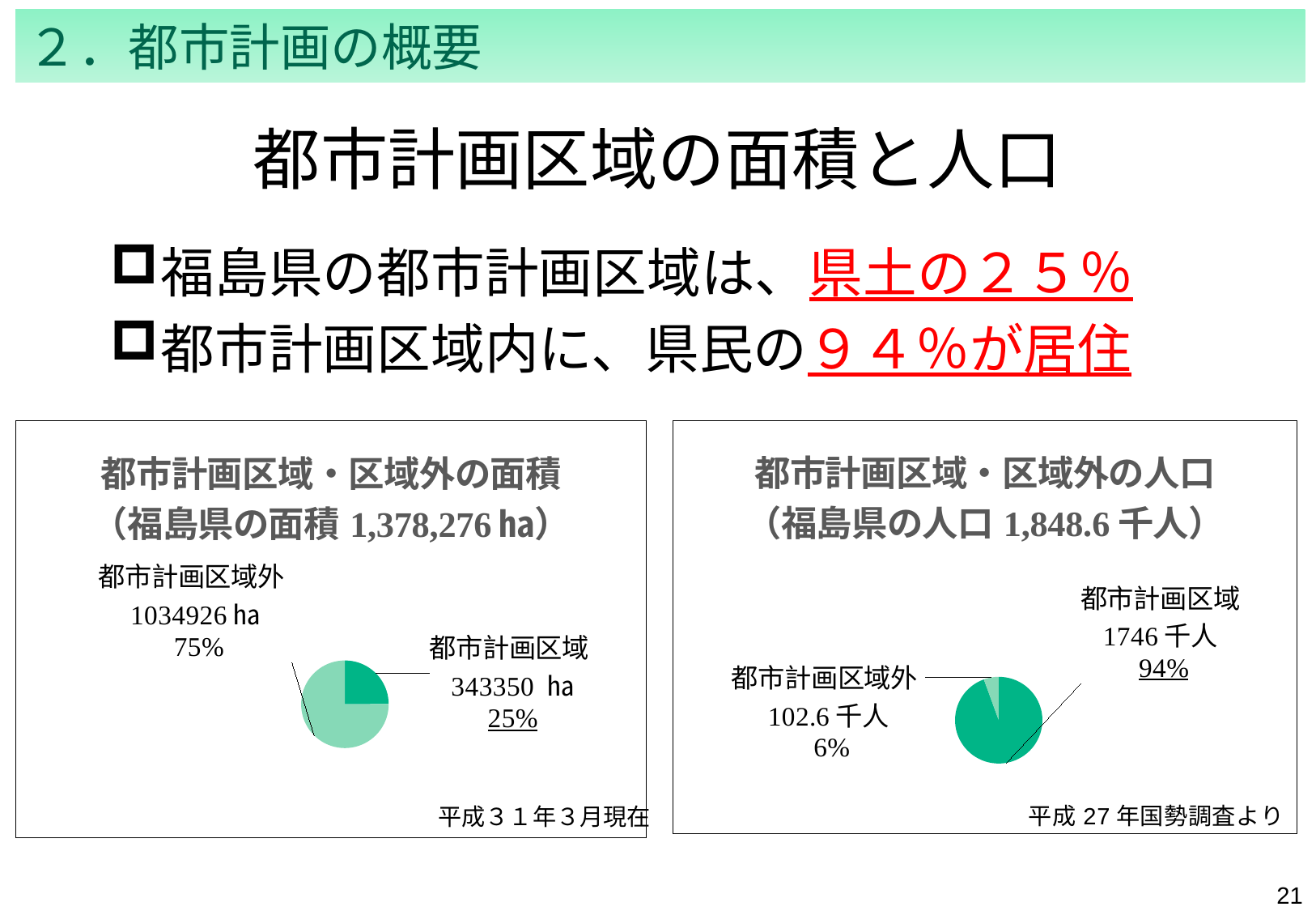
In the left chart (都市計画区域・区域外の面積), what is the area of 都市計画区域? 343350 ha How many slices does the right chart (都市計画区域・区域外の人口) have? 2 In the right chart (都市計画区域・区域外の人口), which slice is the smallest? 都市計画区域外 In the right chart (都市計画区域・区域外の人口), what share of the pie does 都市計画区域外 take? 6% In the right chart (都市計画区域・区域外の人口), what is the population of 都市計画区域? 1746 千人 In the left chart (都市計画区域・区域外の面積), which slice is the largest? 都市計画区域外 In the left chart (都市計画区域・区域外の面積), what is the area of 都市計画区域外? 1034926 ha In the right chart (都市計画区域・区域外の人口), which is larger, 都市計画区域 or 都市計画区域外? 都市計画区域 What kind of chart is the left chart (都市計画区域・区域外の面積)? pie chart In the right chart (都市計画区域・区域外の人口), what is the population of 都市計画区域外? 102.6 千人 In the left chart (都市計画区域・区域外の面積), what share of the pie does 都市計画区域 take? 25% In the left chart (都市計画区域・区域外の面積), what is the difference in area between 都市計画区域外 and 都市計画区域? 691576 ha